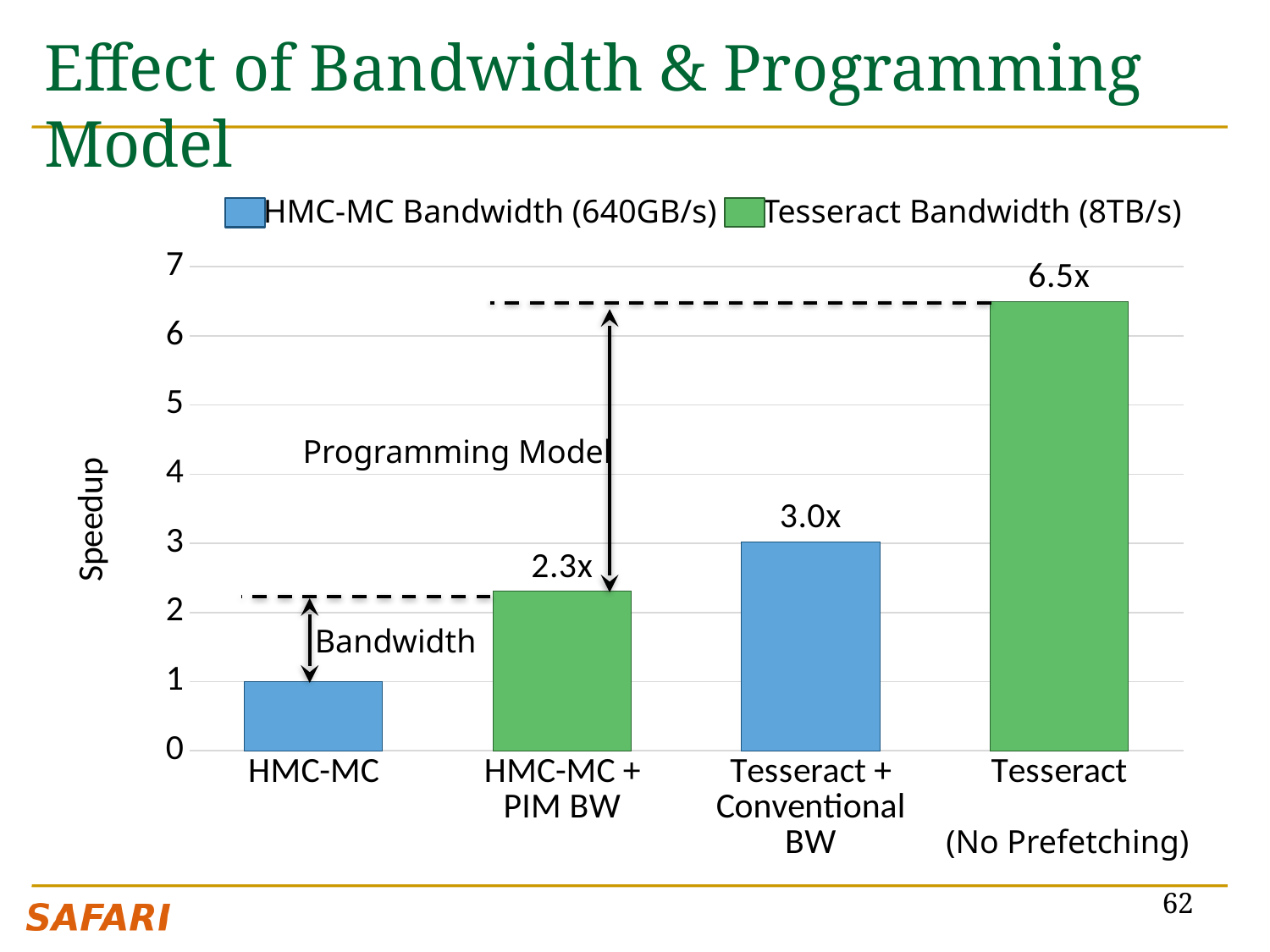
How many series does the legend list? 2 What is the speedup for HMC-MC + PIM BW? 2.3x What kind of chart is shown on the slide? bar chart What is the speedup for Tesseract (No Prefetching)? 6.5x What is the difference in speedup between Tesseract (No Prefetching) and HMC-MC + PIM BW? 4.2x What is the speedup for Tesseract + Conventional BW? 3.0x How many configurations are shown on the x axis? 4 Which has a larger speedup, Tesseract + Conventional BW or HMC-MC + PIM BW? Tesseract + Conventional BW Is the speedup for HMC-MC greater or less than 2? less Which configuration has the lowest speedup? HMC-MC Which configuration has the highest speedup? Tesseract (No Prefetching) What is the difference in speedup between Tesseract + Conventional BW and HMC-MC + PIM BW? 0.7x